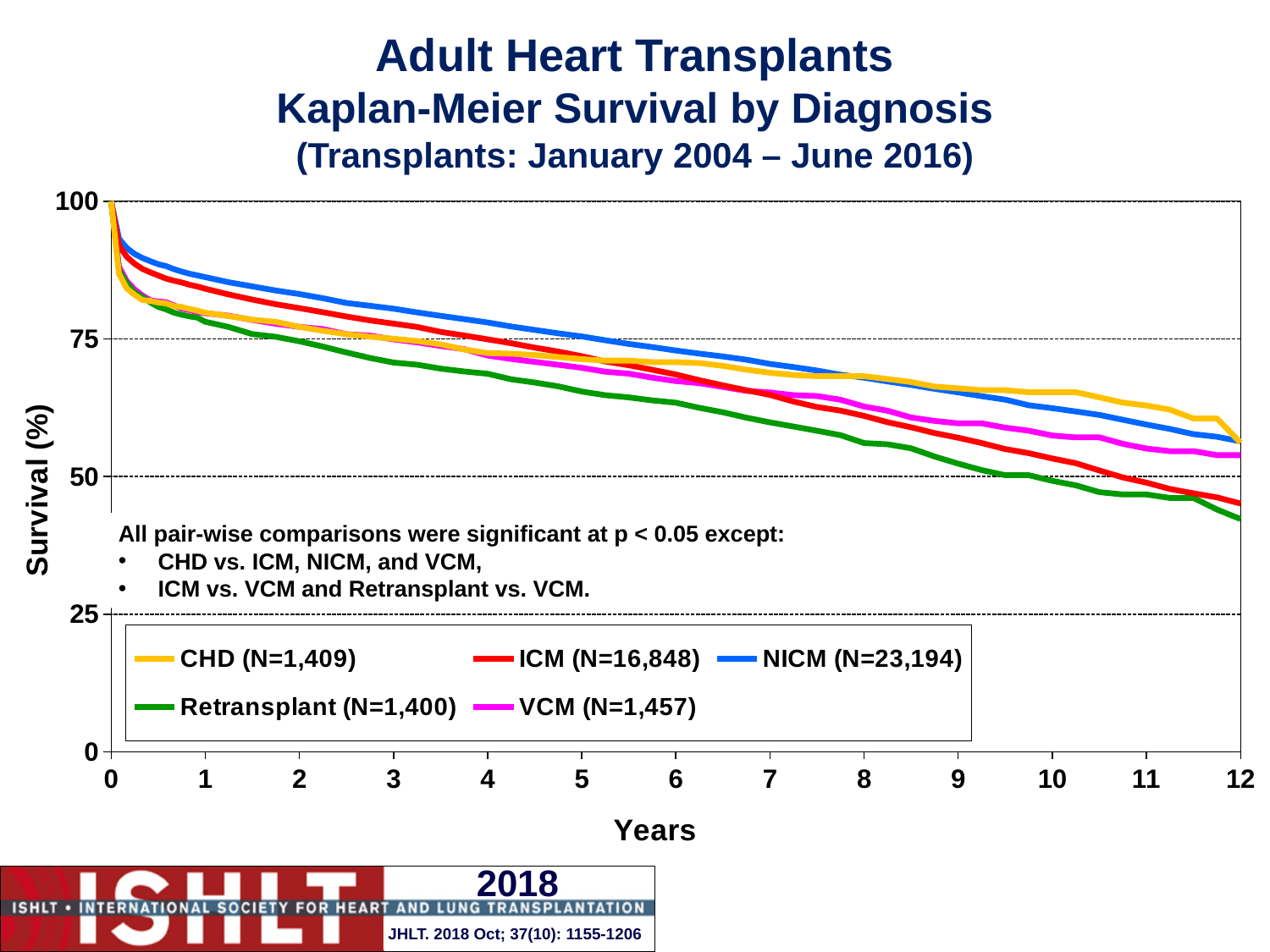
How many series does the legend list? 5 What kind of chart is shown on the slide? line chart At 12 years, which has higher survival, NICM or ICM? NICM Is the survival value for Retransplant at 3 years greater or less than 75? less Is the survival value for ICM at 12 years greater or less than 50? less Is the survival value for Retransplant at 12 years greater or less than 50? less What is the N shown in the legend for ICM? N=16,848 Do the survival curves rise or fall as years increase? fall Which diagnosis group has the highest survival at 1 year? NICM Which diagnosis group has the lowest survival at 6 years? Retransplant